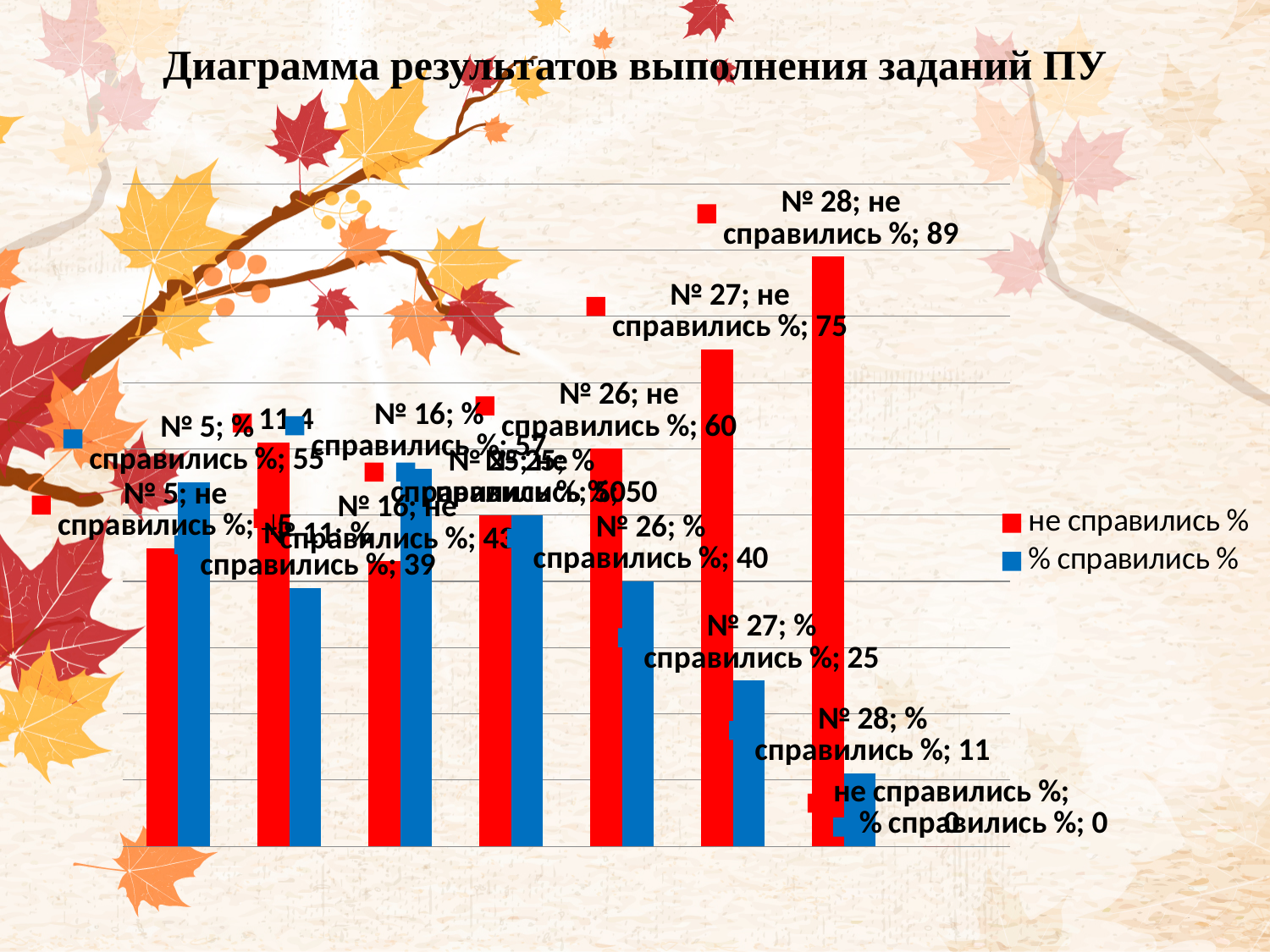
What is the value of "не справились %" for task № 26? 60 What is the value of "не справились %" for task № 28? 89 Which task has the highest "не справились %" value? № 28 What is the value of "% справились" for task № 16? 57 Which is larger: "не справились %" for task № 26 or for task № 27? № 27 Among tasks № 26, № 27 and № 28, which has the lowest "% справились" value? № 28 Do the "не справились %" values rise or fall from task № 26 to task № 28? Rise How many series does the legend list? 2 What kind of chart is shown on the slide? Bar chart What is the value of "% справились" for task № 11? 39 What is the value of "% справились" for task № 27? 25 For task № 27, what is the difference between "не справились %" and "% справились"? 50